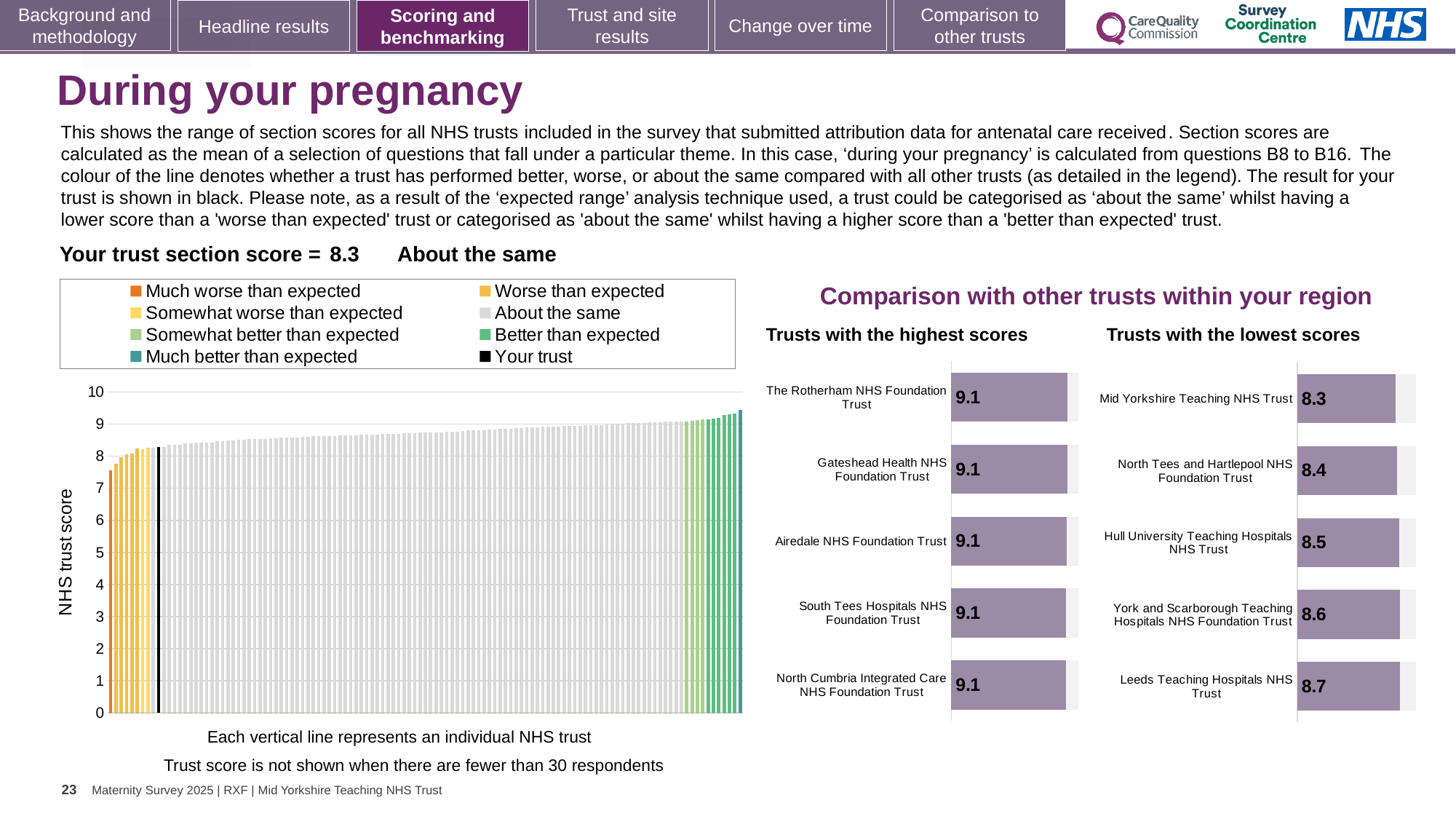
In the 'NHS trust score' chart, is the value for the black 'Your trust' bar greater or less than 5? greater How many entries does the legend above the 'NHS trust score' chart list? 8 In the 'Trusts with the lowest scores' chart, which trust has the lowest score? Mid Yorkshire Teaching NHS Trust In the 'Trusts with the highest scores' chart, what is the score for The Rotherham NHS Foundation Trust? 9.1 In the 'Trusts with the lowest scores' chart, what is the score for Mid Yorkshire Teaching NHS Trust? 8.3 In the 'Trusts with the lowest scores' chart, what is the score for Leeds Teaching Hospitals NHS Trust? 8.7 What kind of chart is the 'NHS trust score' chart on the left of the slide? bar chart In the 'Trusts with the lowest scores' chart, which has the higher score: North Tees and Hartlepool NHS Foundation Trust or York and Scarborough Teaching Hospitals NHS Foundation Trust? York and Scarborough Teaching Hospitals NHS Foundation Trust How many trusts are shown in the 'Trusts with the highest scores' chart? 5 In the 'NHS trust score' chart, do the values rise or fall from left to right? rise In the 'Trusts with the lowest scores' chart, what is the difference between the scores of Leeds Teaching Hospitals NHS Trust and Mid Yorkshire Teaching NHS Trust? 0.4 In the 'Trusts with the lowest scores' chart, which trust has the highest score? Leeds Teaching Hospitals NHS Trust